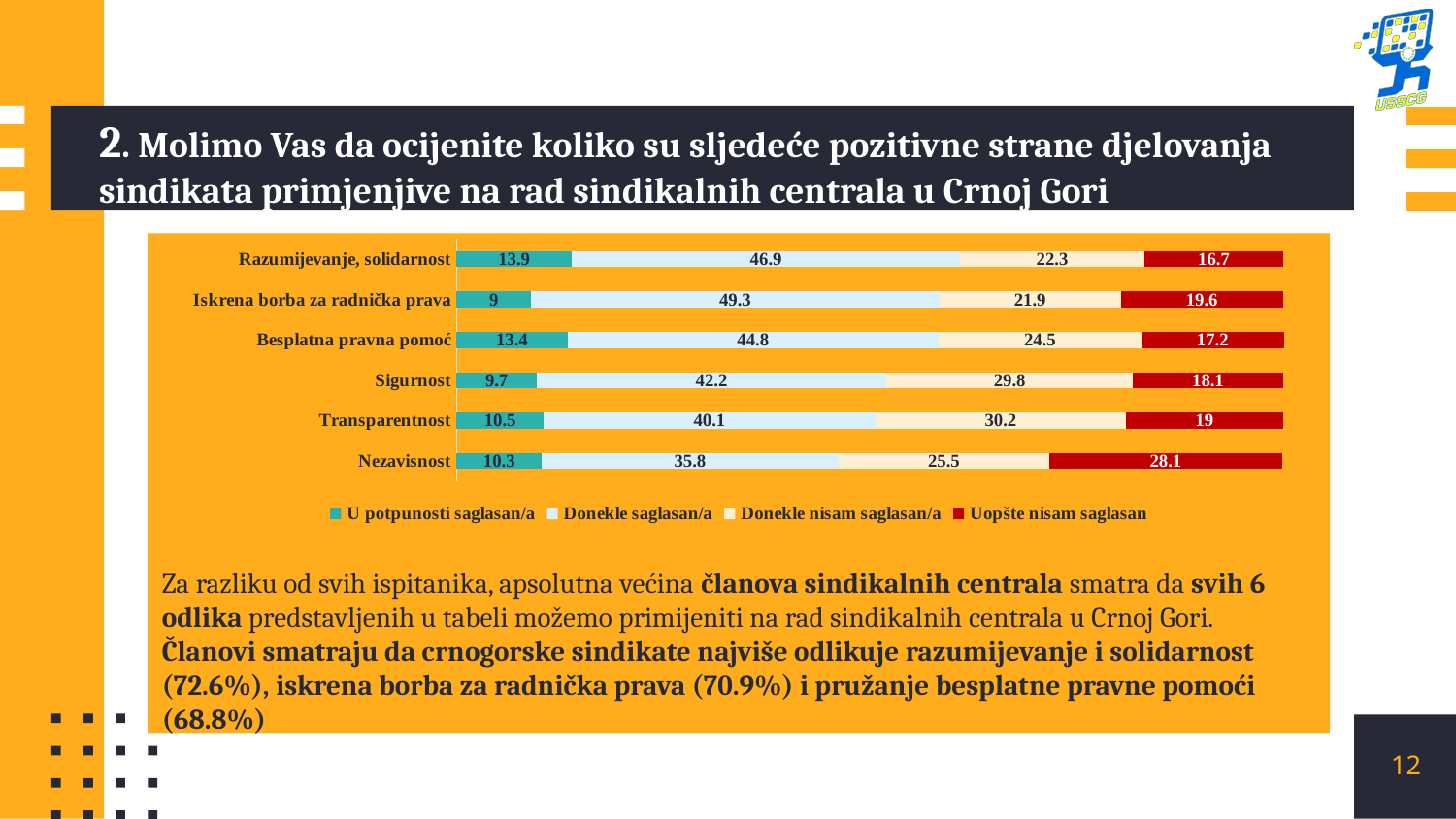
What is the difference between the 'Donekle saglasan/a' values for 'Razumijevanje, solidarnost' and 'Nezavisnost'? 11.1 Which category has the lowest value for 'U potpunosti saglasan/a'? Iskrena borba za radnička prava Which category has the highest value for 'Donekle saglasan/a'? Iskrena borba za radnička prava Which category has the highest value for 'Uopšte nisam saglasan'? Nezavisnost Which is larger: the 'Donekle nisam saglasan/a' value for 'Sigurnost' or for 'Besplatna pravna pomoć'? Sigurnost How many series does the legend list? 4 What is the value of 'U potpunosti saglasan/a' for 'Razumijevanje, solidarnost'? 13.9 What is the value of 'Donekle nisam saglasan/a' for 'Transparentnost'? 30.2 What kind of chart is shown on the slide? Stacked bar chart What is the value of 'Donekle saglasan/a' for 'Iskrena borba za radnička prava'? 49.3 How many categories are plotted in the chart? 6 What is the value of 'Uopšte nisam saglasan' for 'Nezavisnost'? 28.1